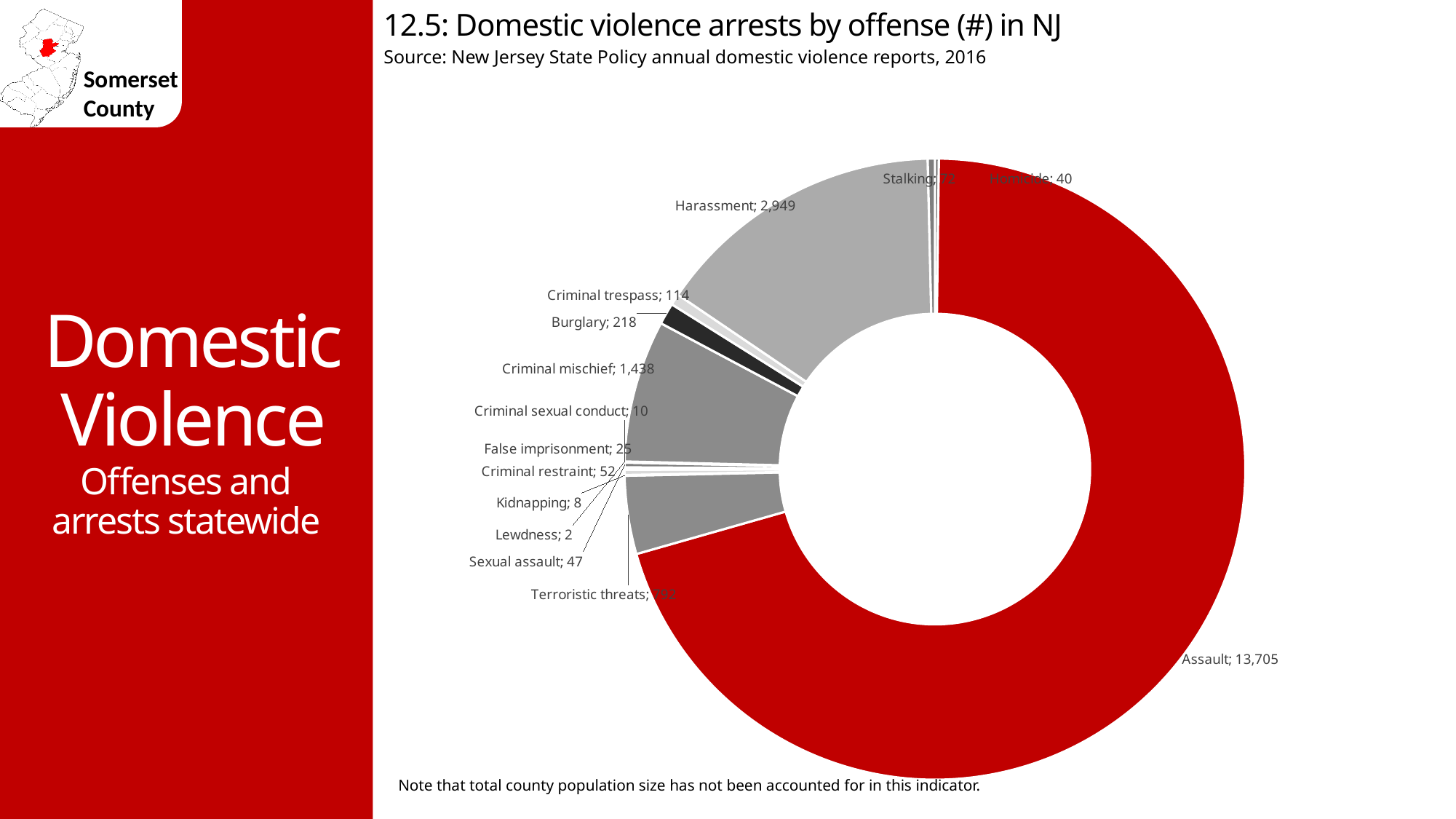
What is the value for Criminal mischief? 1,438 What is the value for Burglary? 218 Which offense has the highest number of arrests? Assault What is the difference between the values for Burglary and Criminal trespass? 104 How many offense categories are shown in the chart? 14 What is the difference between the values for Harassment and Criminal mischief? 1,511 What is the value for Harassment? 2,949 How many arrests for Assault are shown in the chart? 13,705 What type of chart is shown on the slide? Pie chart (donut) Which offense has the lowest number of arrests? Lewdness What is the value for Homicide? 40 Which is larger, the value for Criminal restraint or the value for Sexual assault? Criminal restraint